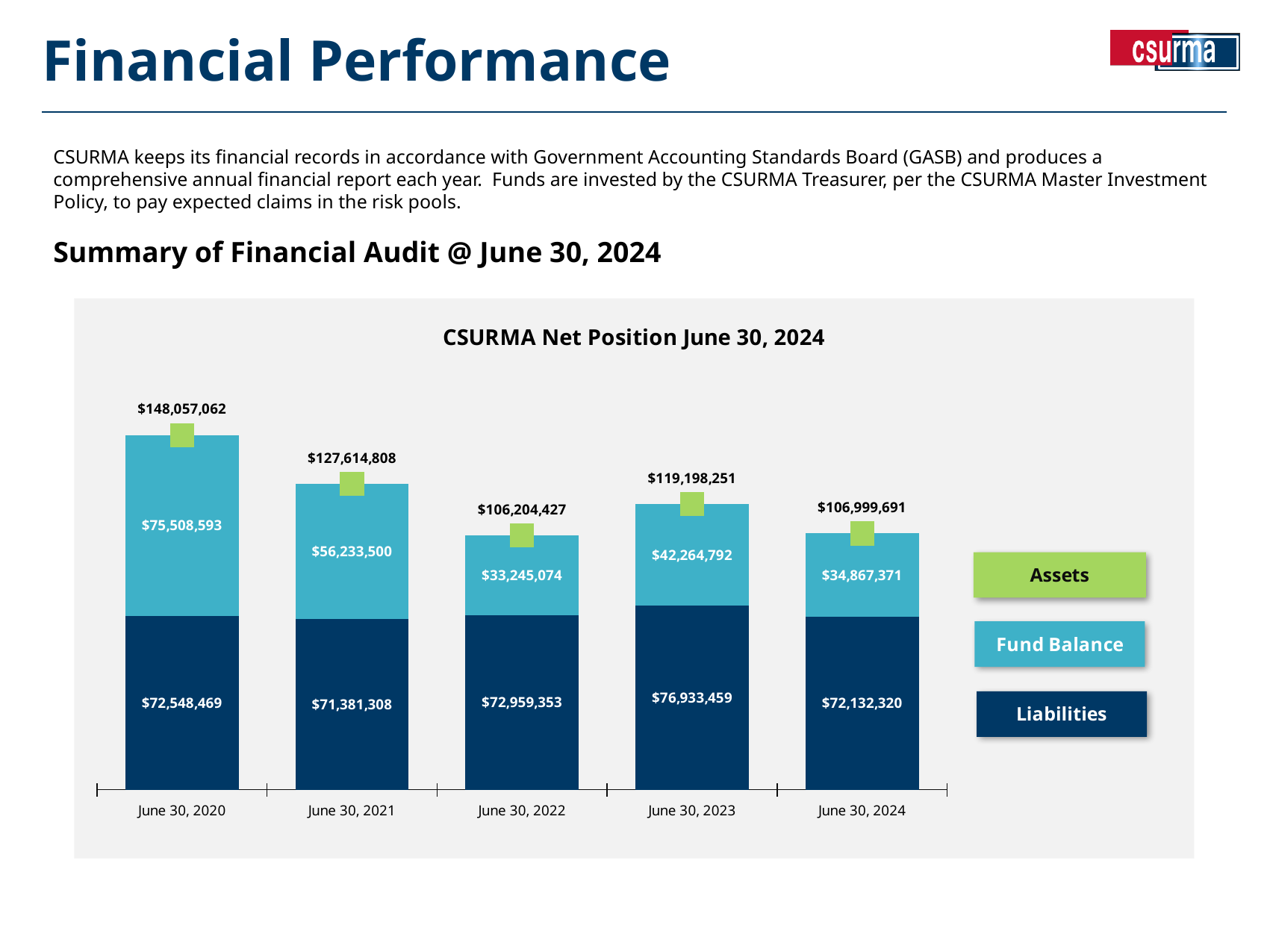
What is the difference between the Fund Balance on June 30, 2020 and on June 30, 2024? $40,641,222 What kind of chart is shown on the slide? Stacked bar chart How many series does the legend list? 3 How many dates are shown on the x axis of the chart? 5 Which date has the highest Liabilities value? June 30, 2023 What is the Liabilities value for June 30, 2023? $76,933,459 Which is larger, the Fund Balance on June 30, 2023 or on June 30, 2024? June 30, 2023 What is the Assets value shown for June 30, 2024? $106,999,691 Which date has the highest Fund Balance? June 30, 2020 Which date has the lowest Fund Balance? June 30, 2022 What is the Fund Balance value for June 30, 2020 in the CSURMA Net Position chart? $75,508,593 What is the difference between the Assets value on June 30, 2020 and on June 30, 2021? $20,442,254